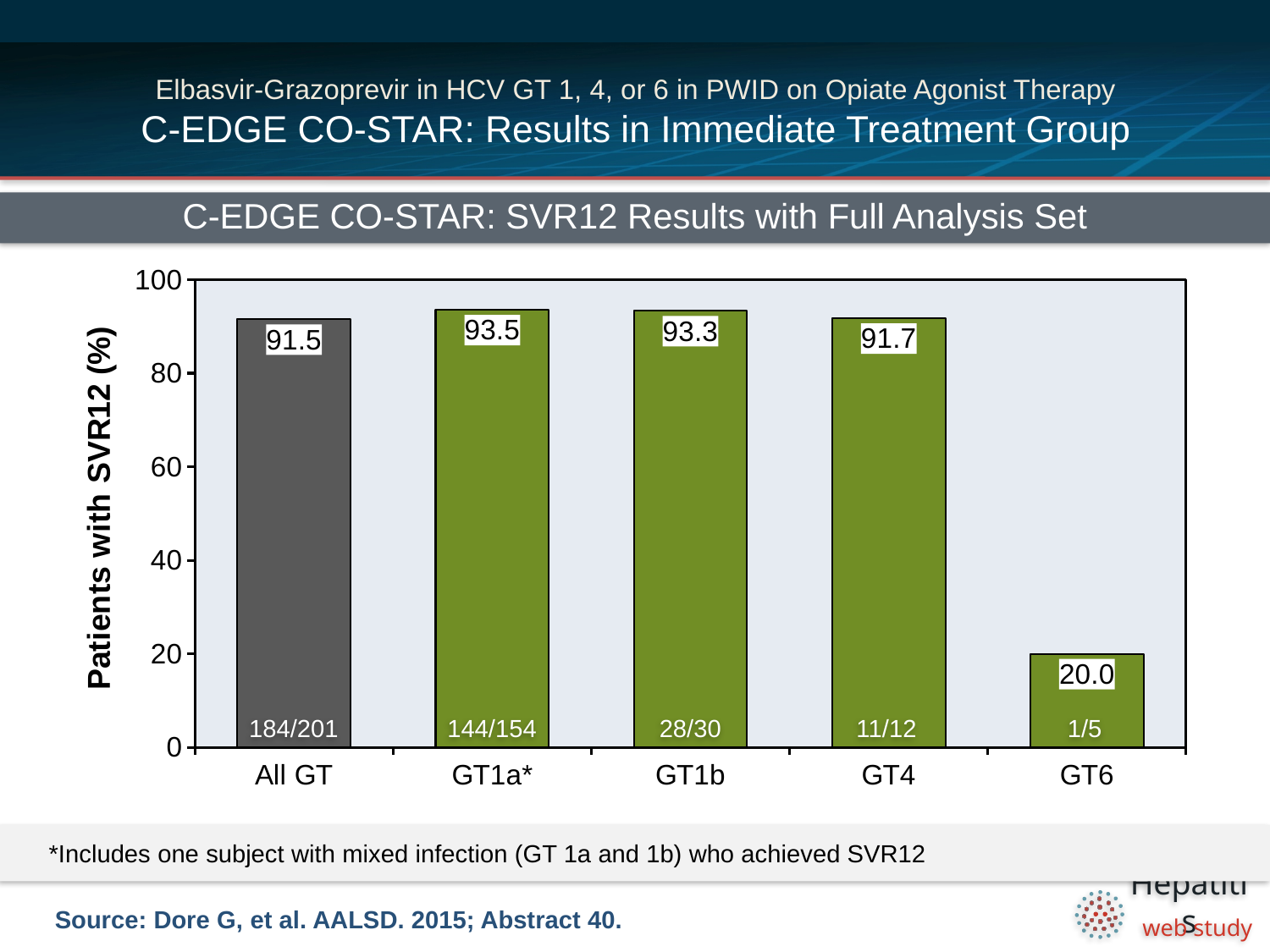
Which category has the lowest SVR12 rate? GT6 What fraction of patients is shown inside the GT4 bar? 11/12 What is the SVR12 rate for All GT? 91.5 What is the title of the chart? C-EDGE CO-STAR: SVR12 Results with Full Analysis Set Which has a higher SVR12 rate, GT4 or GT1b? GT1b What kind of chart is shown? bar chart How many categories are shown on the x axis? 5 What is the SVR12 rate for GT1b? 93.3 Is the value for GT6 greater or less than 40? less What is the y-axis label of the chart? Patients with SVR12 (%) Which category has the highest SVR12 rate? GT1a* What is the difference between the SVR12 rates for GT1a* and GT6? 73.5